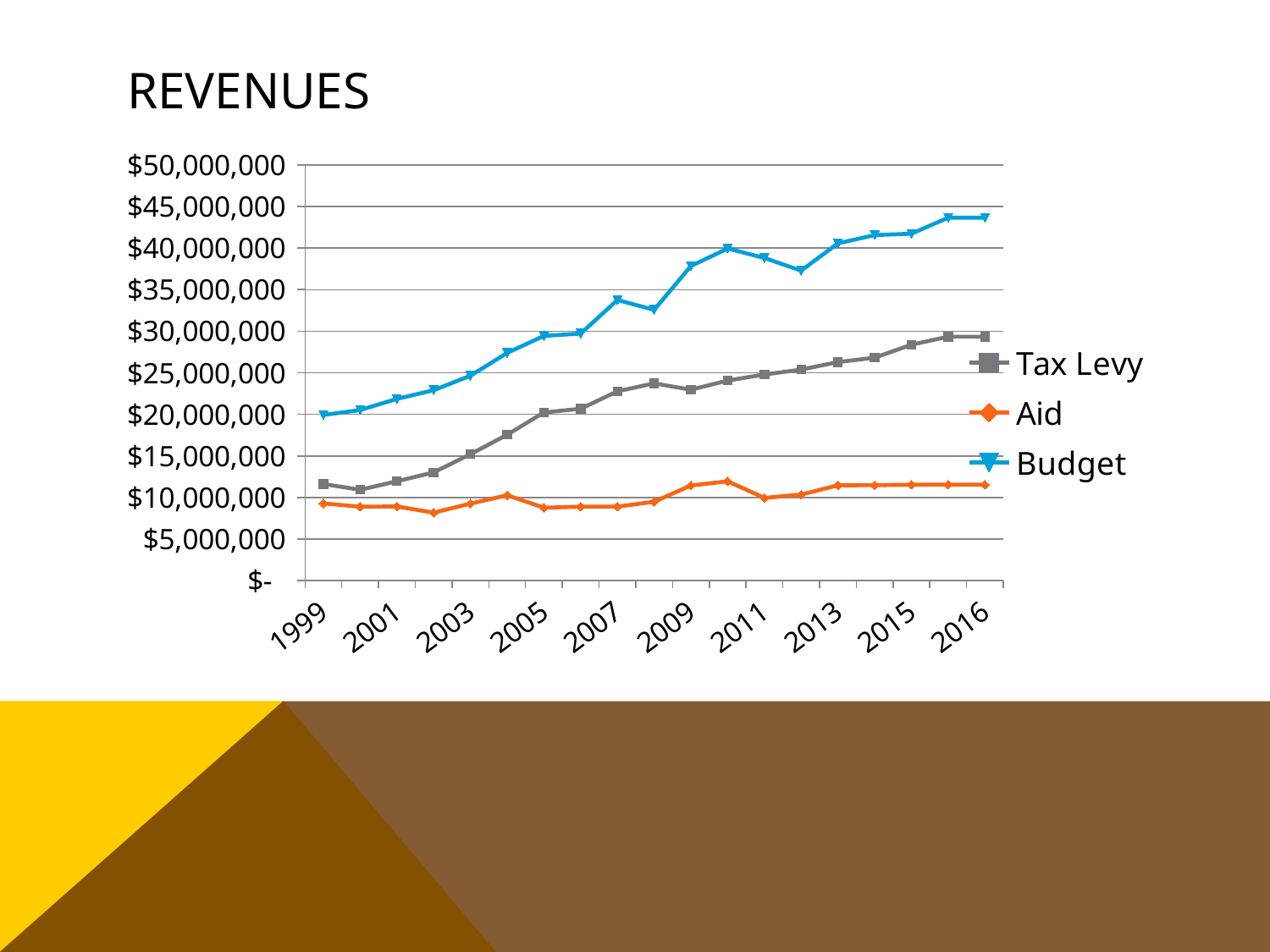
Is the Budget value for 1999 greater or less than $25,000,000? less Is the Tax Levy value for 1999 greater or less than $15,000,000? less What are the three series named in the legend? Tax Levy, Aid, Budget Is the Aid value for 2016 greater or less than $15,000,000? less What kind of chart is shown on the slide? line chart How many series does the legend list? 3 In 2009, which is larger: Tax Levy or Aid? Tax Levy Does the Budget series generally rise or fall from 1999 to 2016? rise Which series has the lowest values across all years? Aid Which series has the highest values across all years? Budget